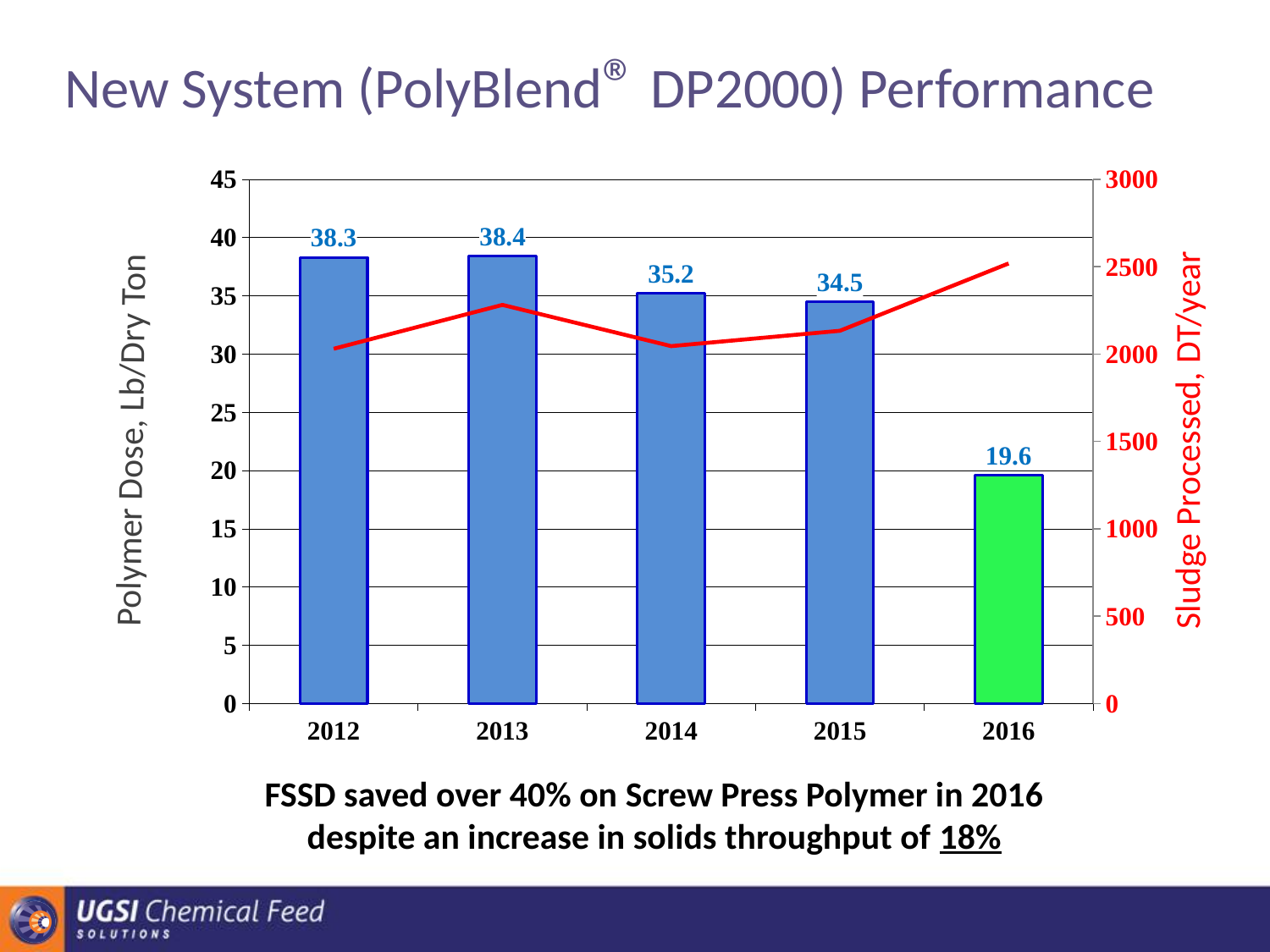
What is the polymer dose for 2012? 38.3 What is the polymer dose for 2016? 19.6 In which year is the sludge processed (red line) highest? 2016 Is the sludge processed value for 2016 greater or less than 2000 DT/year? greater What is the polymer dose for 2014? 35.2 What is the label of the right-hand (secondary) y axis? Sludge Processed, DT/year Is the sludge processed value for 2013 greater or less than 2500 DT/year? less How many years are shown on the x axis? 5 Which year has the lowest polymer dose? 2016 What is the difference in polymer dose between 2015 and 2016? 14.9 Which year has the larger polymer dose, 2014 or 2015? 2014 Which year has the highest polymer dose? 2013